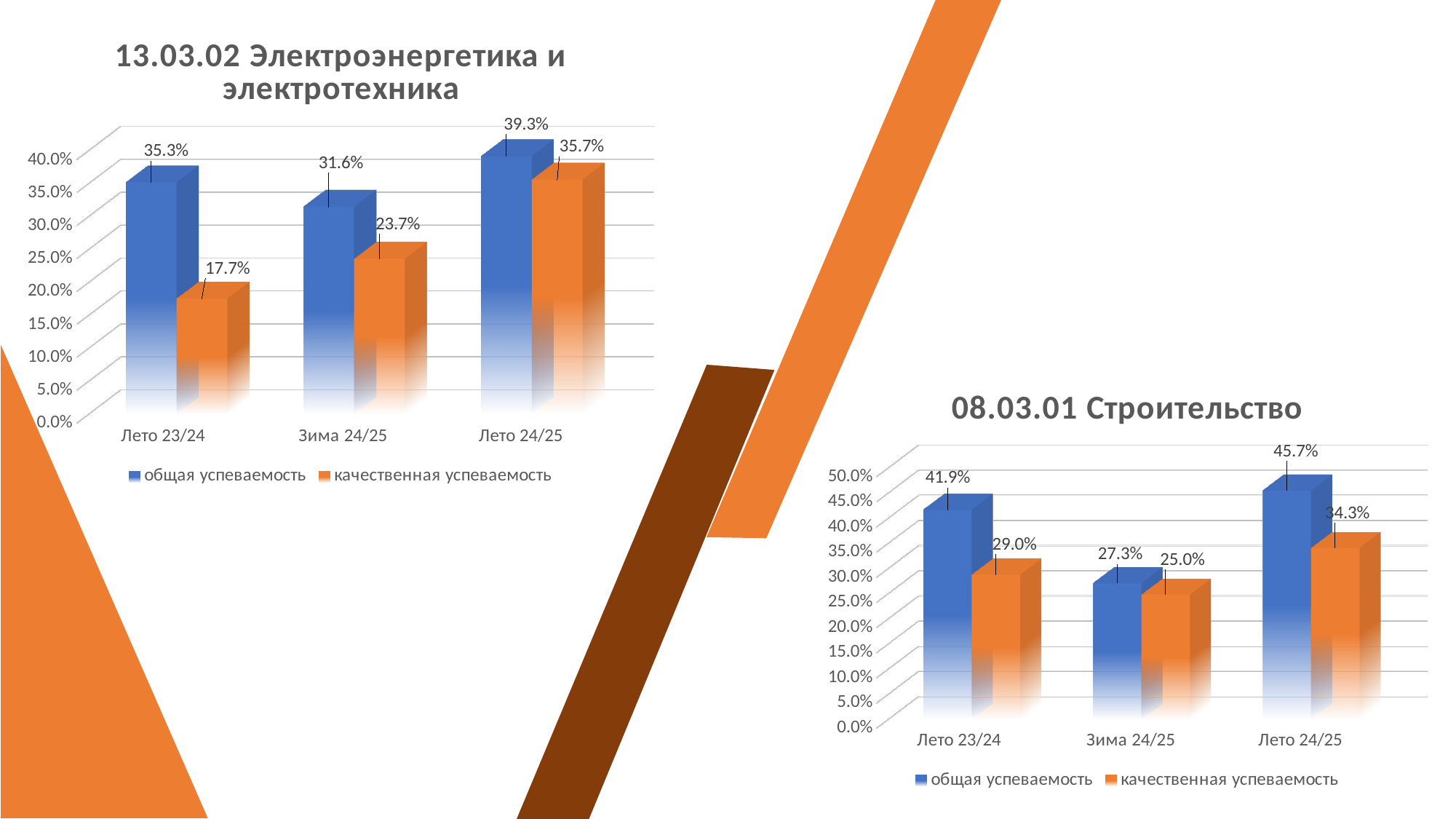
In the chart titled "08.03.01 Строительство", which is larger: качественная успеваемость for Лето 23/24 or for Зима 24/25? Лето 23/24 In the chart titled "13.03.02 Электроэнергетика и электротехника", what is the value of качественная успеваемость for Зима 24/25? 23.7% In the chart titled "08.03.01 Строительство", what is the value of качественная успеваемость for Лето 24/25? 34.3% In the chart titled "13.03.02 Электроэнергетика и электротехника", which period has the highest общая успеваемость? Лето 24/25 In the chart titled "08.03.01 Строительство", which period has the lowest качественная успеваемость? Зима 24/25 In the chart titled "08.03.01 Строительство", what is the value of общая успеваемость for Зима 24/25? 27.3% In the chart titled "13.03.02 Электроэнергетика и электротехника", what is the difference between общая успеваемость and качественная успеваемость for Лето 23/24? 17.6% In the chart titled "13.03.02 Электроэнергетика и электротехника", does качественная успеваемость rise or fall from Лето 23/24 to Лето 24/25? rise In the chart titled "08.03.01 Строительство", what is the difference between общая успеваемость for Лето 24/25 and Лето 23/24? 3.8% In the chart titled "13.03.02 Электроэнергетика и электротехника", what is the value of общая успеваемость for Лето 23/24? 35.3% How many series does the legend list in the chart titled "08.03.01 Строительство"? 2 What kind of chart is the chart titled "13.03.02 Электроэнергетика и электротехника"? bar chart